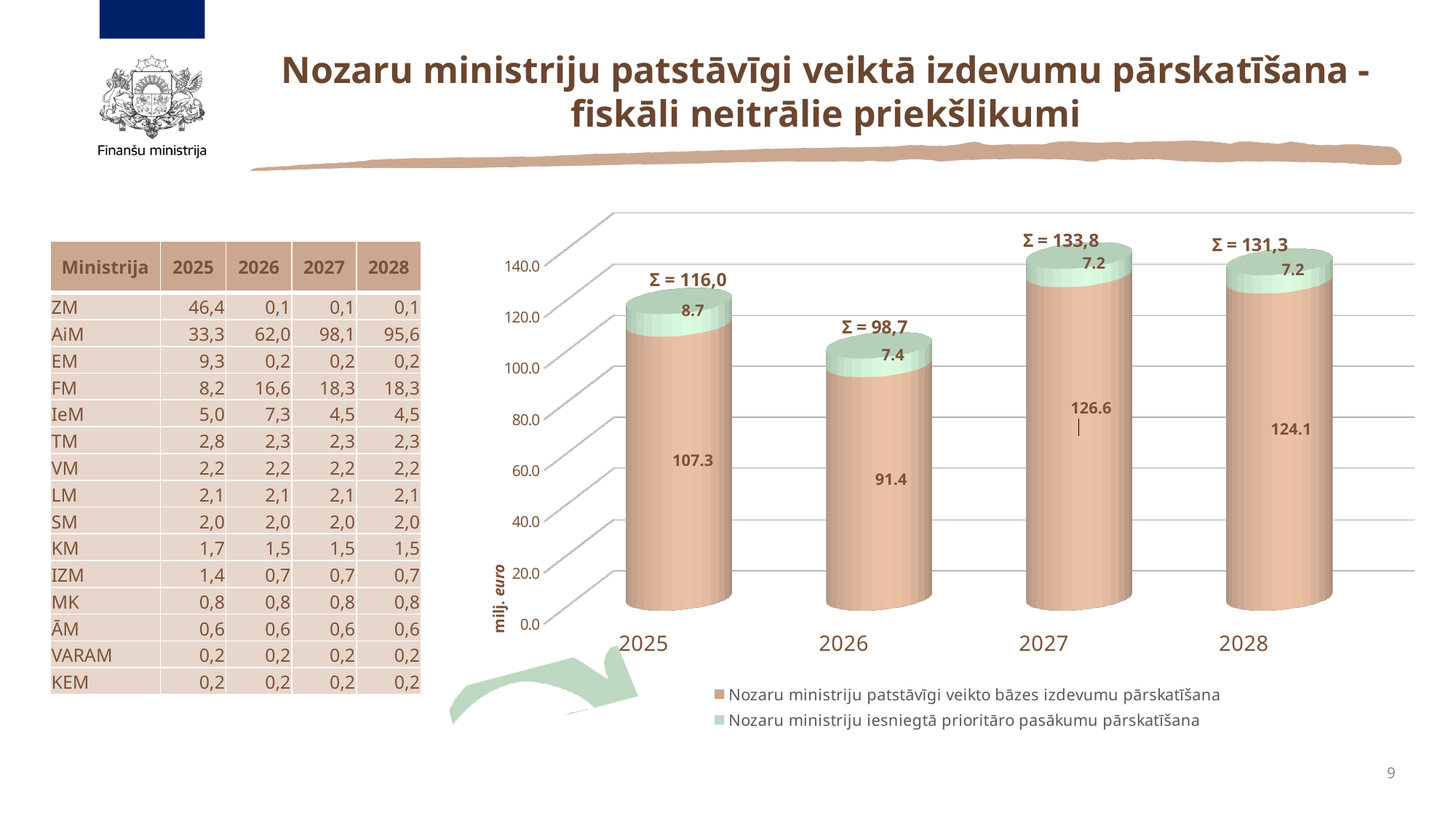
Which year has the highest total in the chart? 2027 What type of chart is shown on the slide? bar chart What is the total (Σ) shown for the 2028 bar? 131,3 What is the value of the base expenditure review series (Nozaru ministriju patstāvīgi veikto bāzes izdevumu pārskatīšana) for 2025? 107.3 Is the base expenditure review value for 2025 larger or smaller than the value for 2028? smaller What is the difference between the base expenditure review values for 2027 and 2026? 35.2 What is the value of the base expenditure review series for 2027? 126.6 How many years are shown on the x axis of the chart? 4 How many series does the chart legend list? 2 Which year has the lowest total in the chart? 2026 What is the value of the priority measures review series (Nozaru ministriju iesniegtā prioritāro pasākumu pārskatīšana) for 2026? 7.4 What unit is shown on the vertical axis of the chart? milj. euro